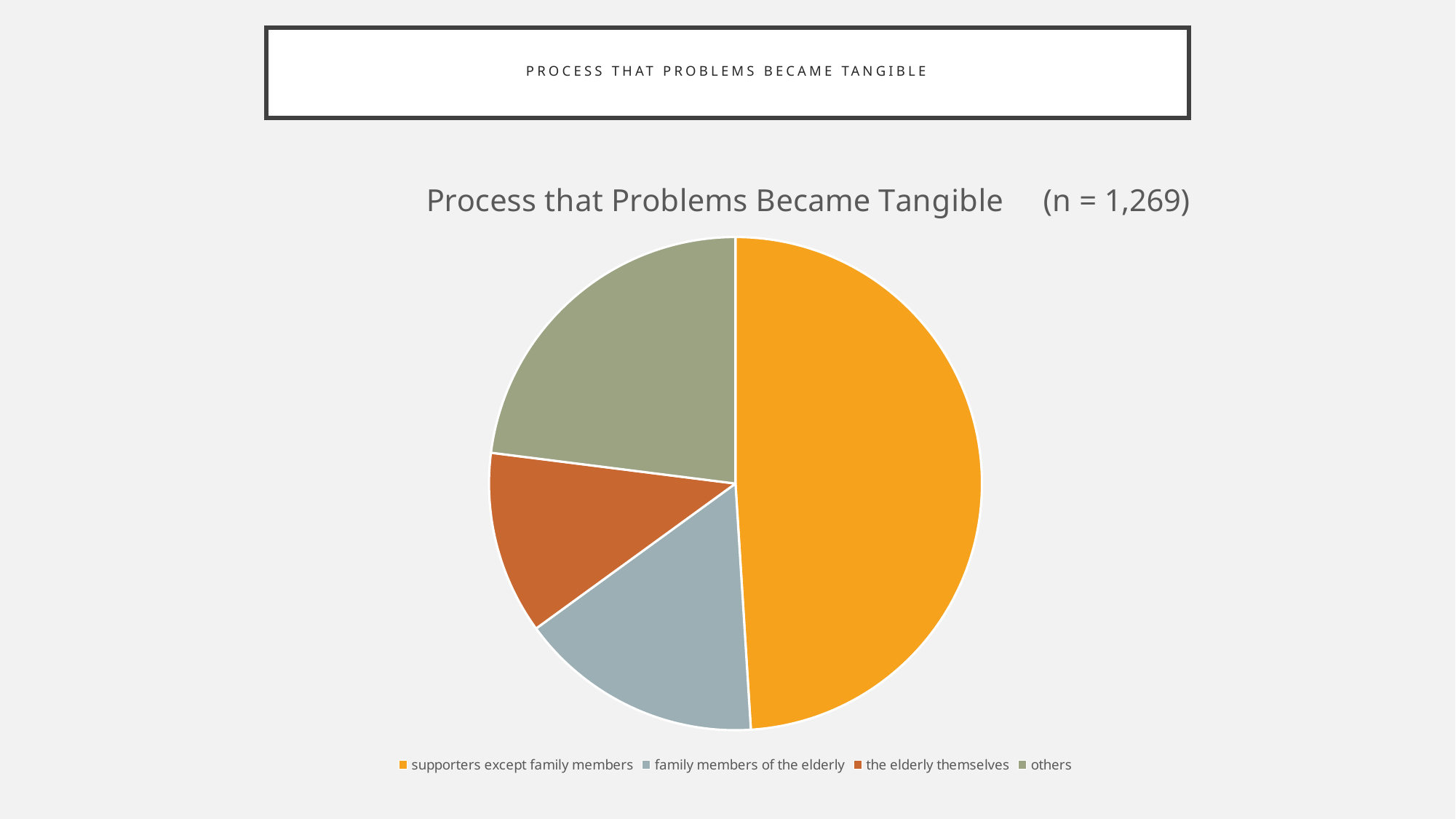
Which category has the smallest slice of the pie? the elderly themselves Which slice is larger: supporters except family members or others? supporters except family members What is the title of the chart? Process that Problems Became Tangible (n = 1,269) Which slice is larger: others or family members of the elderly? others Which slice is larger: others or the elderly themselves? others Which category has the largest slice of the pie? supporters except family members What sample size (n) is shown in the chart title? 1,269 How many entries does the legend list? 4 What kind of chart is shown on the slide? pie chart How many slices does the pie chart have? 4